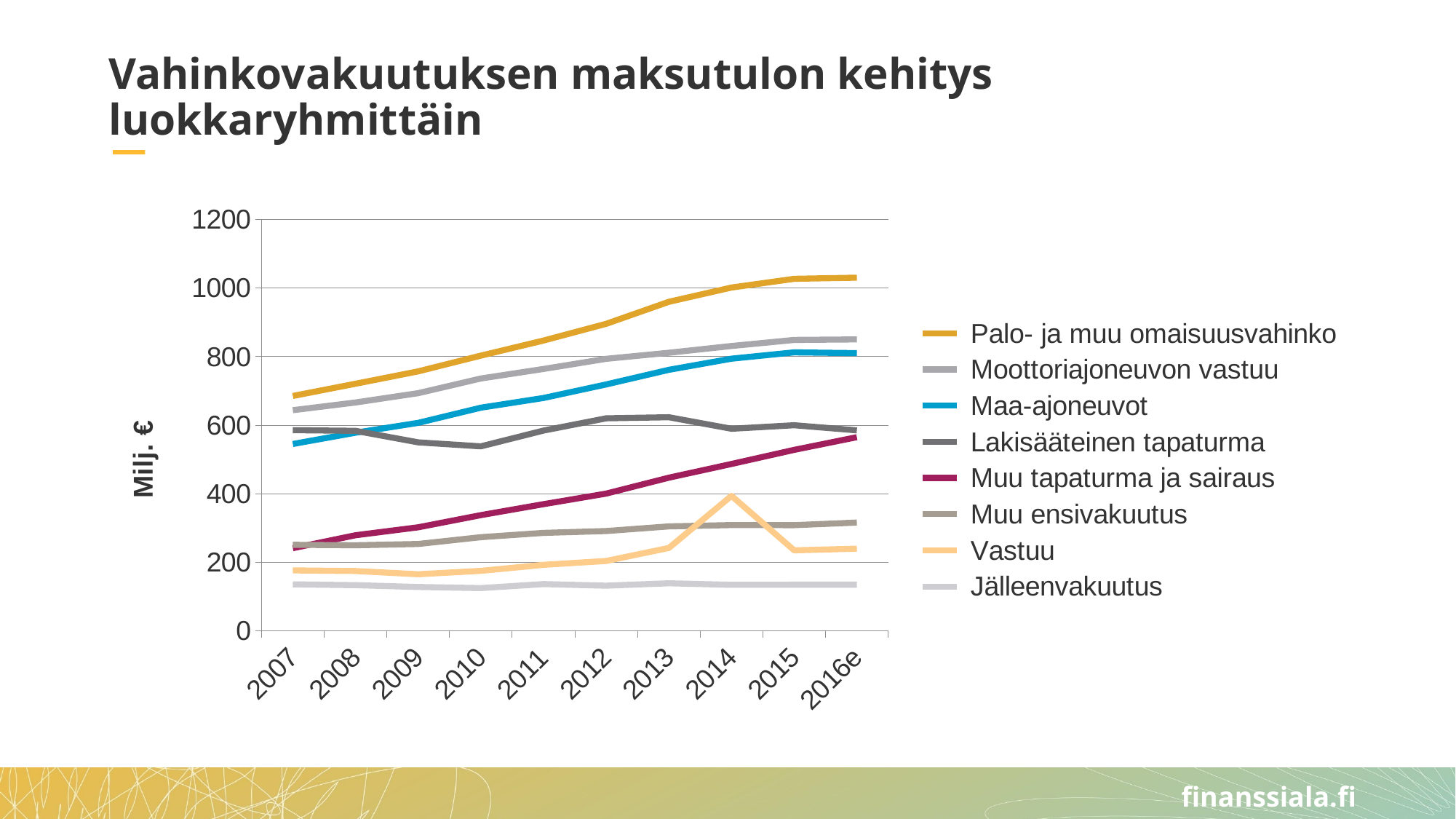
Is the value for Palo- ja muu omaisuusvahinko in 2016e greater or less than 1000? greater Which series has the highest value in 2016e? Palo- ja muu omaisuusvahinko Which series has the lowest value in 2016e? Jälleenvakuutus In which year does the Vastuu series reach its peak? 2014 Does the Muu tapaturma ja sairaus series rise or fall from 2007 to 2016e? rise How many years are shown on the x axis? 10 Is the value for Maa-ajoneuvot in 2007 greater or less than 600? less What kind of chart is shown on the slide? line chart Is the value for Moottoriajoneuvon vastuu in 2015 greater or less than 800? greater How many series does the legend list? 8 In 2014, which is larger: Vastuu or Muu ensivakuutus? Vastuu What is the label on the y axis of the chart? Milj. €